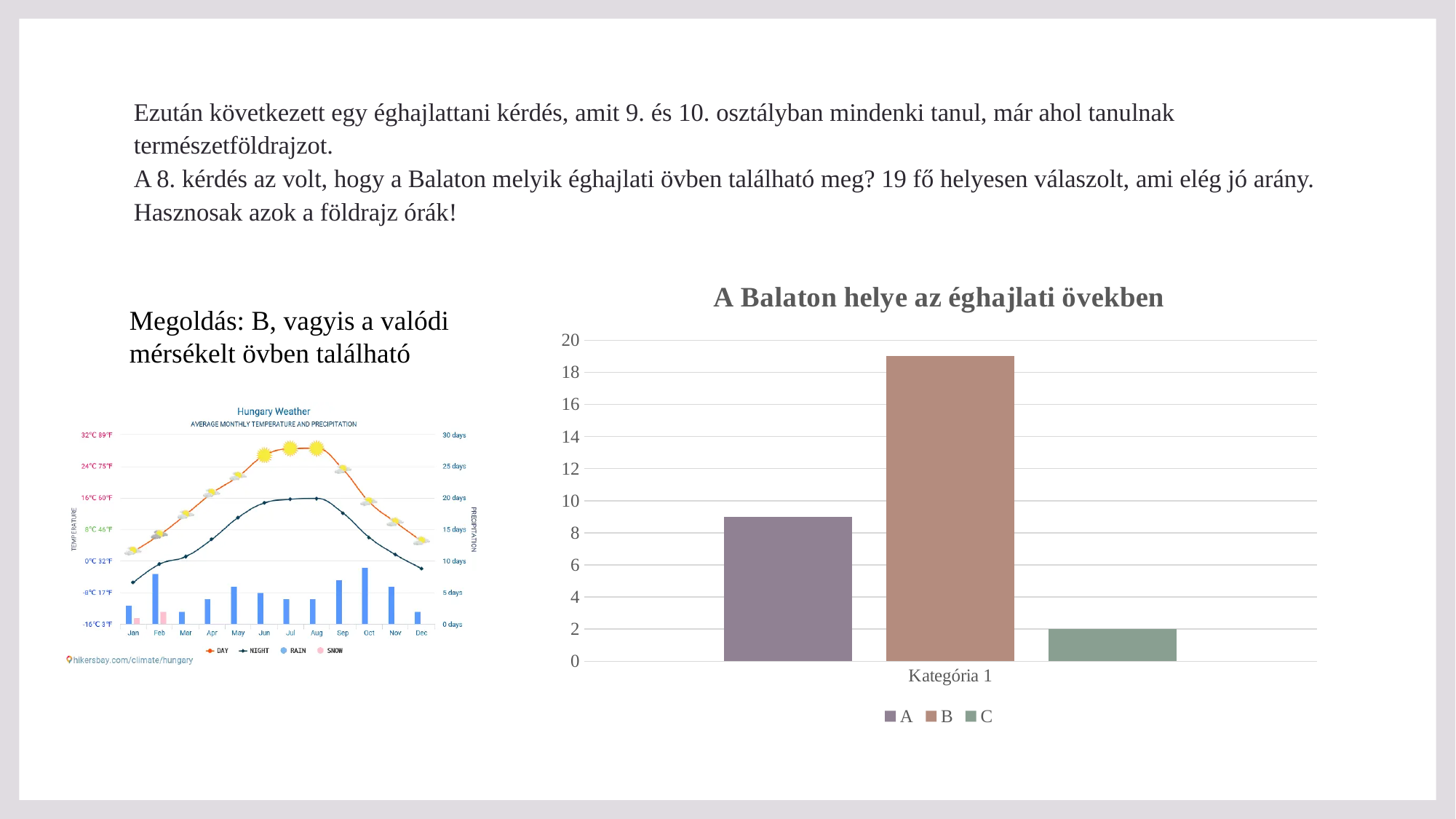
In the chart titled 'A Balaton helye az éghajlati övekben', which series has the highest bar? B In the chart titled 'A Balaton helye az éghajlati övekben', is the value for series B greater or less than 18? greater In the chart titled 'A Balaton helye az éghajlati övekben', what kind of chart is shown? bar chart In the chart titled 'A Balaton helye az éghajlati övekben', is the value for series A greater or less than 8? greater In the chart titled 'A Balaton helye az éghajlati övekben', which series has the lowest bar? C In the chart titled 'A Balaton helye az éghajlati övekben', how many series does the legend list? 3 In the chart titled 'A Balaton helye az éghajlati övekben', what is the label of the category on the x axis? Kategória 1 In the chart titled 'A Balaton helye az éghajlati övekben', is the value for series A greater or less than 10? less In the 'Hungary Weather' chart on the left, how many months are shown on the x axis? 12 In the chart titled 'A Balaton helye az éghajlati övekben', what is the highest value shown on the vertical axis? 20 In the chart titled 'A Balaton helye az éghajlati övekben', what is the value for series C? 2 In the chart titled 'A Balaton helye az éghajlati övekben', which is larger, the value for A or the value for C? A